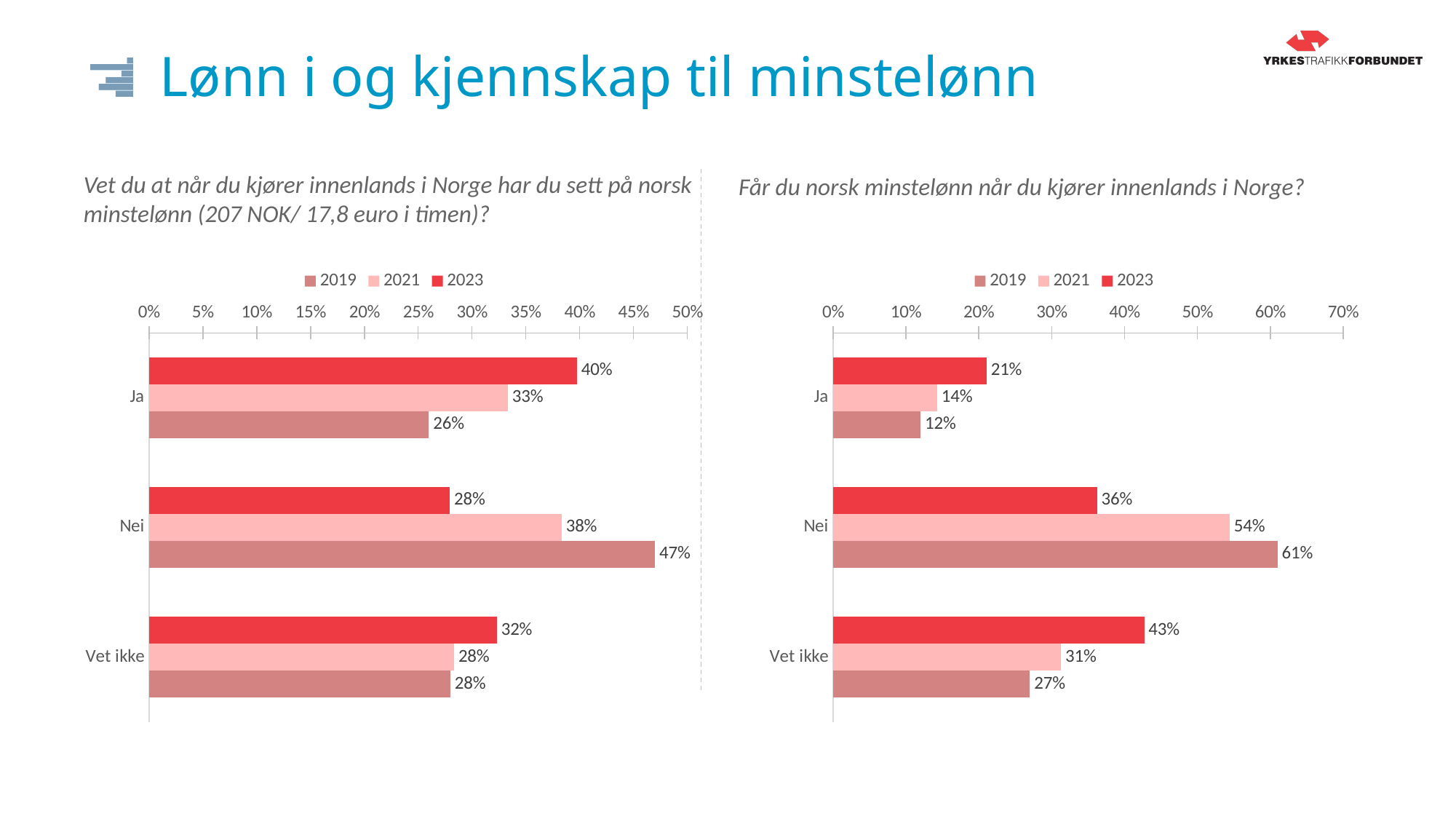
In the right chart, which is larger: the 2023 value for Nei or the 2023 value for Vet ikke? Vet ikke In the left chart ("Vet du at når du kjører innenlands i Norge..."), what is the value for Ja in 2023? 40% In the right chart, what is the difference between the 2023 and 2019 values for Ja? 9% In the left chart, which category has the lowest value for 2019? Ja In the left chart, what is the value for Nei in 2019? 47% In the left chart, what is the difference between the 2019 and 2023 values for Nei? 19% In the right chart, which category has the highest value for 2019? Nei In the right chart, what is the value for Vet ikke in 2023? 43% What kind of chart is the left chart? Bar chart In the right chart ("Får du norsk minstelønn..."), what is the value for Nei in 2021? 54% How many categories are shown in the right chart? 3 How many series does the legend of the left chart list? 3